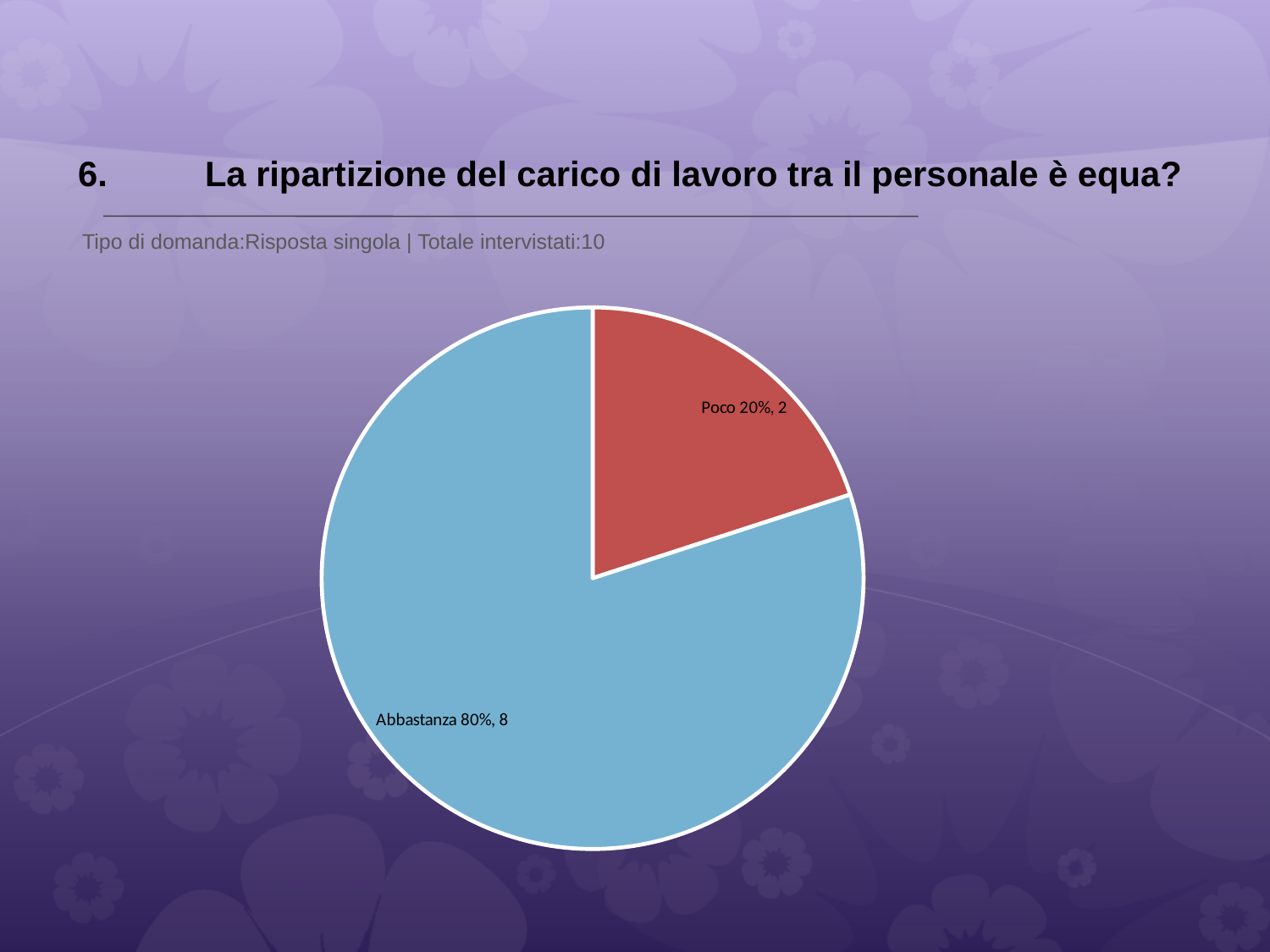
What kind of chart is shown on the slide? pie chart How many respondents answered "Poco"? 2 What is the total number of respondents shown in the pie chart? 10 Which slice is the smallest in the pie chart? Poco Which has more respondents, "Abbastanza" or "Poco"? Abbastanza What share of the pie does the "Poco" slice represent? 20% How many slices does the pie chart have? 2 What colour is the "Poco" slice? red How many respondents answered "Abbastanza"? 8 What is the difference in number of respondents between "Abbastanza" and "Poco"? 6 What share of the pie does the "Abbastanza" slice represent? 80% Which slice is the largest in the pie chart? Abbastanza